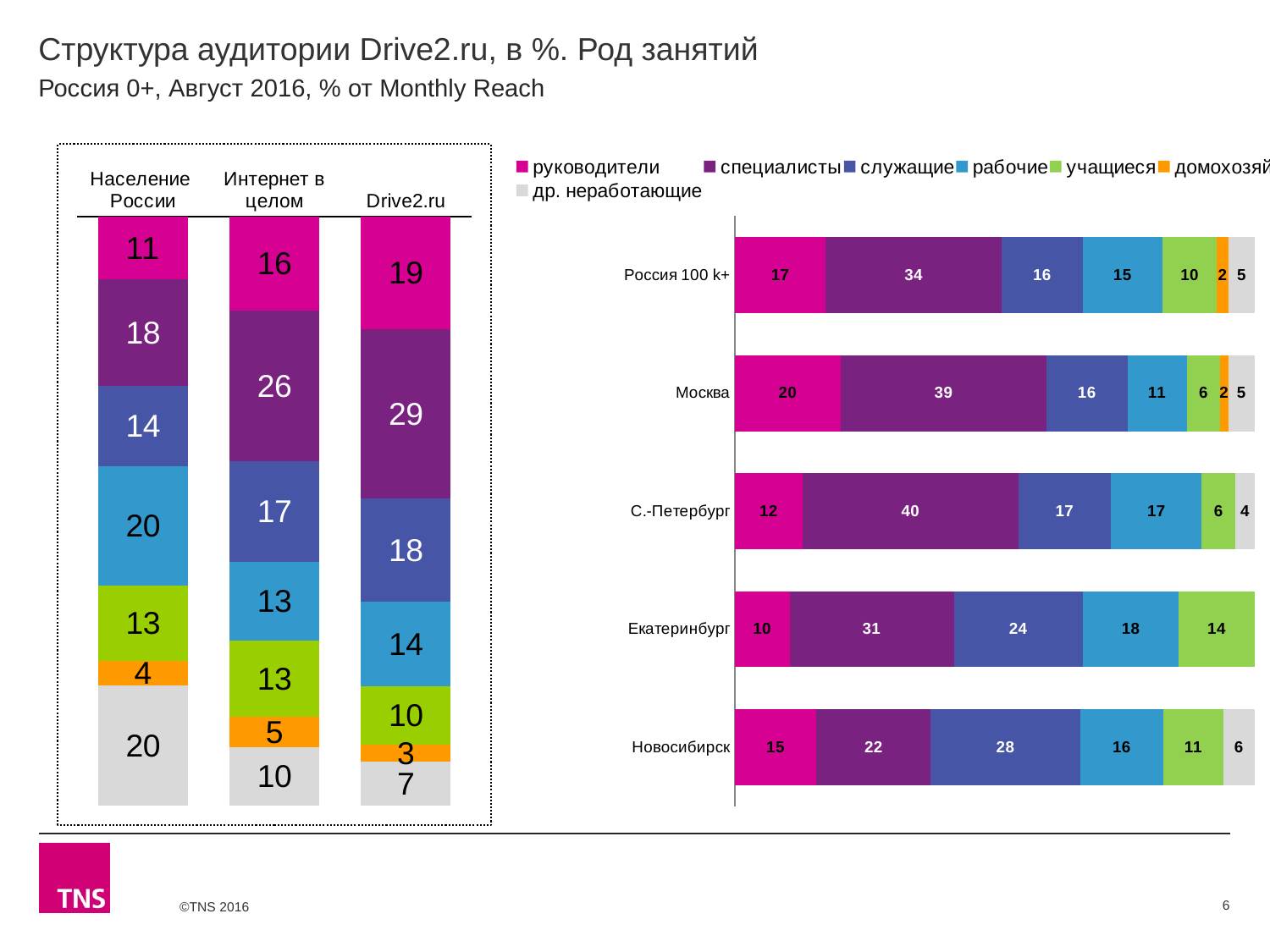
On the right chart, which city has the highest специалисты (purple) value? С.-Петербург On the left chart, what is the value of the bottom grey segment for Население России? 20 On the left chart, which of the three bars has the largest руководители (pink) segment? Drive2.ru On the right chart, how many categories (rows) are shown? 5 On the right chart, which is larger: the рабочие value for Екатеринбург or for Москва? Екатеринбург On the left chart, what is the difference between the специалисты (purple) segment for Drive2.ru and for Население России? 11 On the left chart, what is the value of the специалисты (purple) segment for Drive2.ru? 29 What type of chart is the right chart? Stacked bar chart On the left chart, how many bars (categories) are shown? 3 How many series does the legend list? 7 On the right chart, what is the value of the специалисты (purple) segment for Москва? 39 On the right chart, what is the value of the служащие segment for Новосибирск? 28